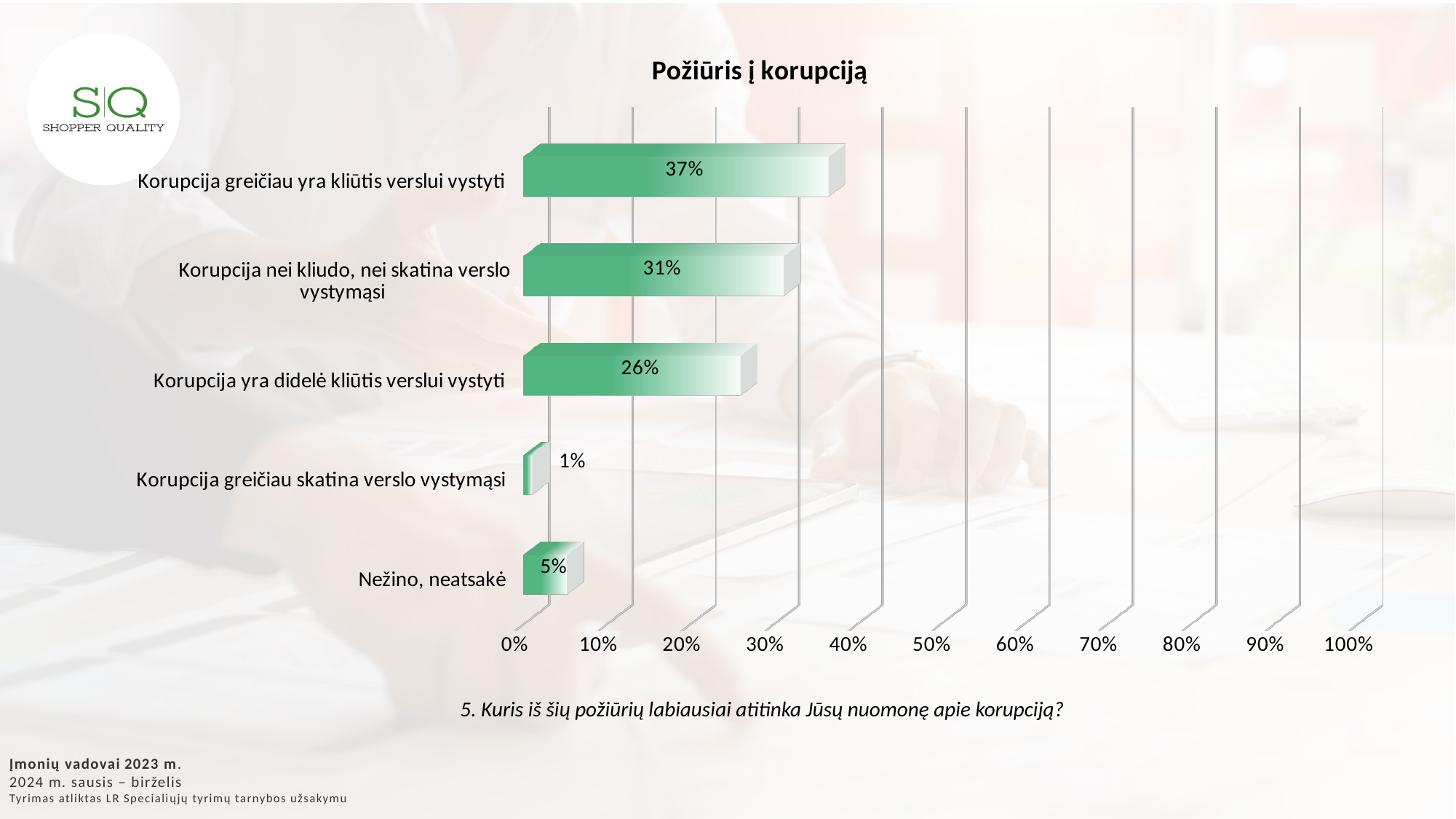
How many categories are shown in the chart? 5 Which category has the lowest value? Korupcija greičiau skatina verslo vystymąsi What is the value for "Korupcija greičiau skatina verslo vystymąsi"? 1% What is the value for "Korupcija greičiau yra kliūtis verslui vystyti"? 37% Which is larger: the value for "Korupcija nei kliudo, nei skatina verslo vystymąsi" or for "Nežino, neatsakė"? Korupcija nei kliudo, nei skatina verslo vystymąsi What is the title of the chart? Požiūris į korupciją What is the value for "Nežino, neatsakė"? 5% What is the difference between the values for "Korupcija greičiau yra kliūtis verslui vystyti" and "Korupcija yra didelė kliūtis verslui vystyti"? 11% What is the value for "Korupcija yra didelė kliūtis verslui vystyti"? 26% What kind of chart is shown on the slide? Bar chart What is the value for "Korupcija nei kliudo, nei skatina verslo vystymąsi"? 31% Which category has the highest value? Korupcija greičiau yra kliūtis verslui vystyti